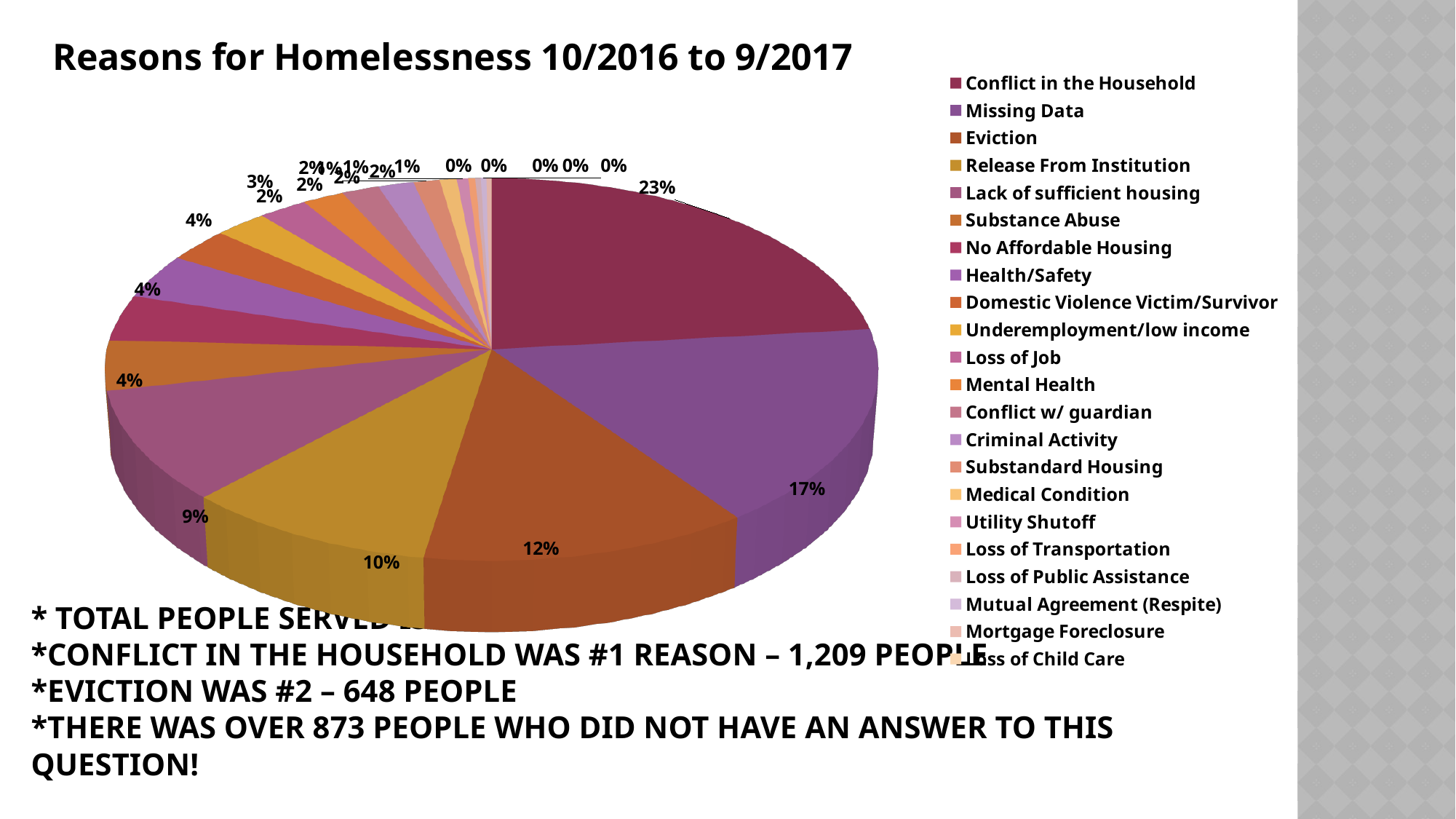
What is the difference in percentage points between Conflict in the Household and Missing Data? 6 What is the title of the chart? Reasons for Homelessness 10/2016 to 9/2017 What is the difference in percentage points between Eviction and Lack of sufficient housing? 3 Which slice is larger, Eviction or Release From Institution? Eviction What percentage of the pie is Eviction? 12% What percentage of the pie is Conflict in the Household? 23% What kind of chart is shown on the slide? Pie chart What percentage of the pie is Release From Institution? 10% What percentage of the pie is Missing Data? 17% How many categories does the legend list? 22 Which reason has the largest share of the pie? Conflict in the Household What percentage of the pie is Lack of sufficient housing? 9%